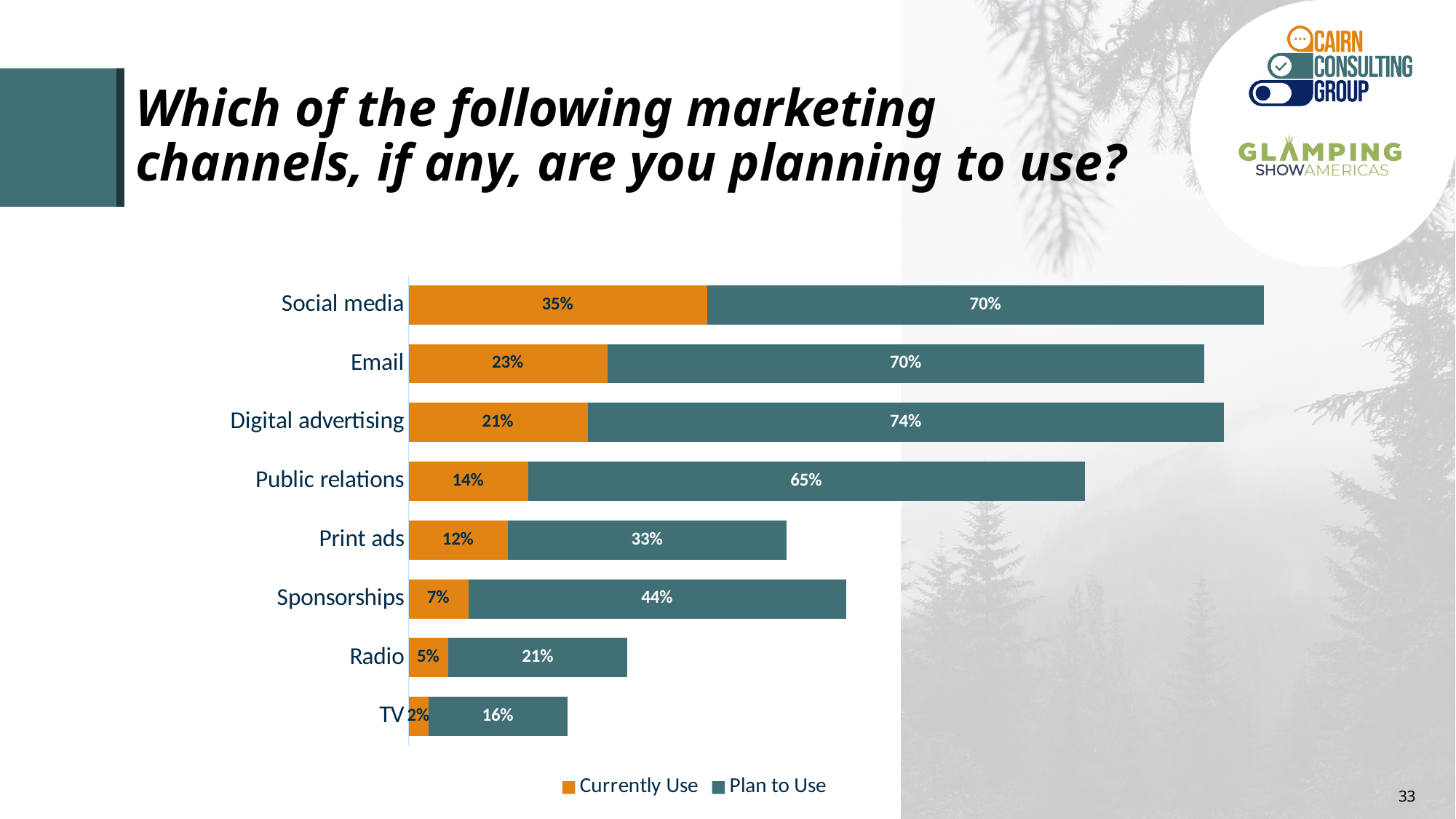
What percentage of respondents currently use social media? 35% How many series does the legend list? 2 What kind of chart is shown on the slide? Stacked bar chart Which colour represents 'Currently Use' in the chart? Orange Which marketing channel has the highest 'Currently Use' value? Social media What is the total of the stacked bar for Email? 93% What percentage of respondents plan to use digital advertising? 74% How many marketing channels are shown in the chart? 8 What is the 'Plan to Use' value for sponsorships? 44% Which is larger: the 'Plan to Use' value for print ads or for sponsorships? Sponsorships Which marketing channel has the lowest 'Plan to Use' value? TV What is the difference between the 'Plan to Use' and 'Currently Use' values for public relations? 51%